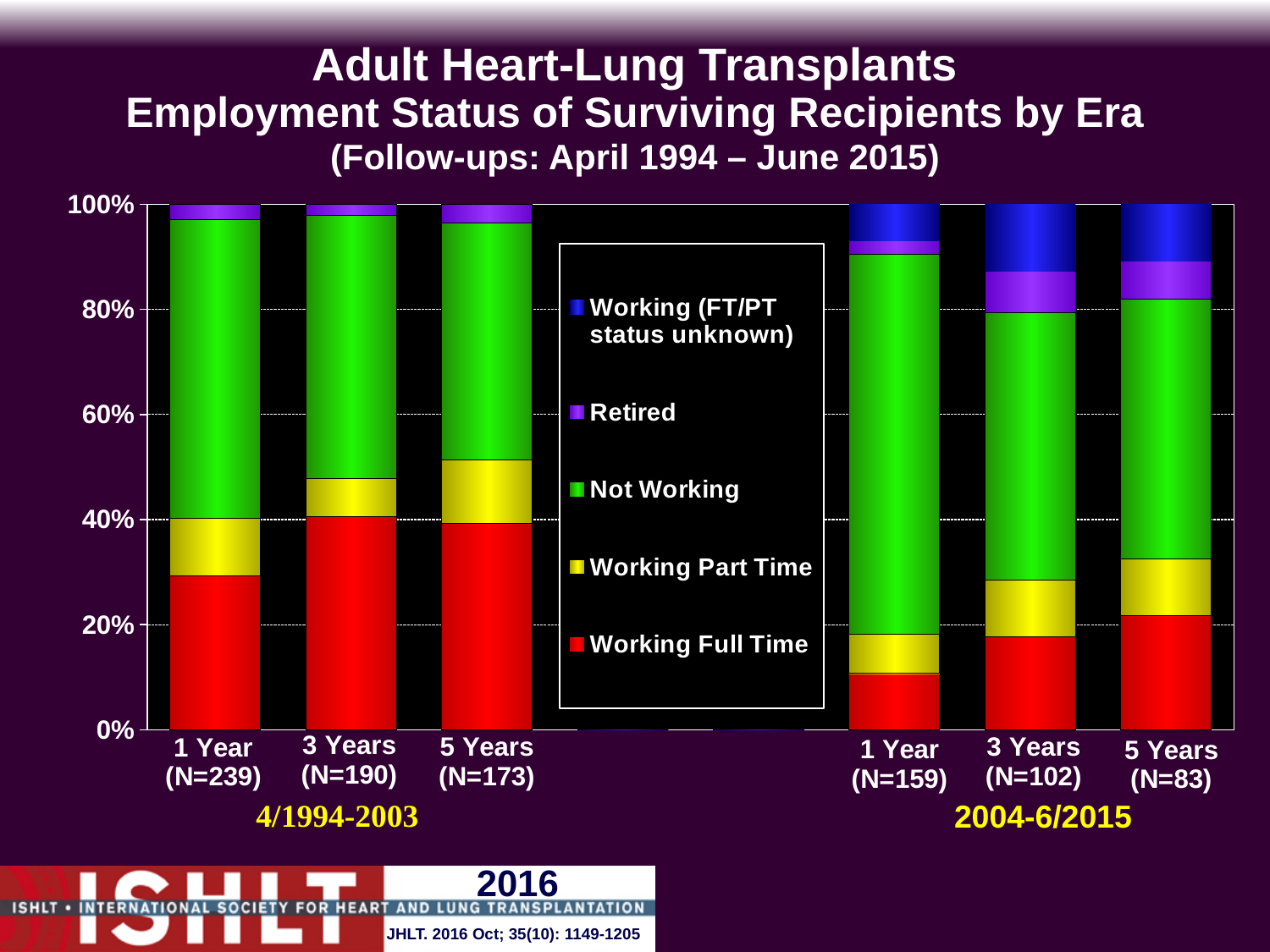
Is the Working Full Time share for 1 Year (N=239) in the 4/1994-2003 era greater or less than 20%? greater In the 2004-6/2015 era, does the Working Full Time share rise or fall from 1 Year to 5 Years? Rises Which has the larger Retired share: 3 Years (N=102) in 2004-6/2015 or 1 Year (N=239) in 4/1994-2003? 3 Years (N=102) in 2004-6/2015 Is the Working Full Time share for 3 Years (N=102) in the 2004-6/2015 era greater or less than 20%? less What is the N for the 5 Years bar in the 2004-6/2015 era? N=83 Which has the larger Working Full Time share: 1 Year (N=239) in 4/1994-2003 or 1 Year (N=159) in 2004-6/2015? 1 Year (N=239) in 4/1994-2003 Is the Working Full Time share for 1 Year (N=159) in the 2004-6/2015 era greater or less than 20%? less Which legend entry is shown in green? Not Working How many bars are plotted in the chart? 6 What kind of chart is shown on the slide? Stacked bar chart How many series does the legend list? 5